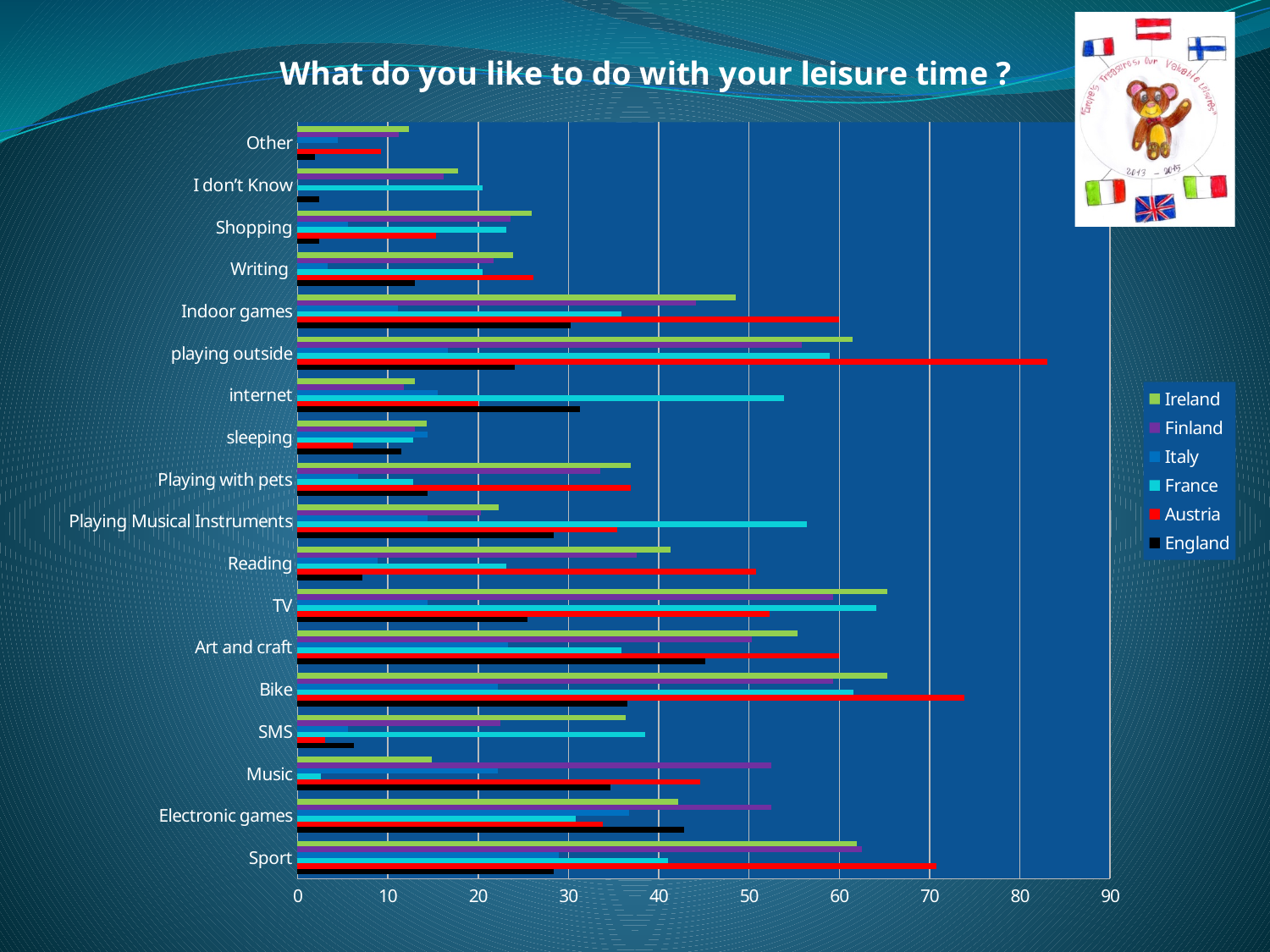
Is the value for Austria in the 'playing outside' category greater or less than 80? greater Is the value for France in the 'internet' category greater or less than 50? greater How many countries does the legend list? 6 For 'Sport', which is larger: the value for Ireland or the value for Austria? Austria Is the value for England in the 'Other' category greater or less than 10? less What kind of chart is shown on the slide? bar chart Which country has the highest value for 'playing outside'? Austria How many leisure activity categories are shown on the chart? 18 Which country has the highest value for 'Bike'? Austria What is the title of the chart? What do you like to do with your leisure time ?